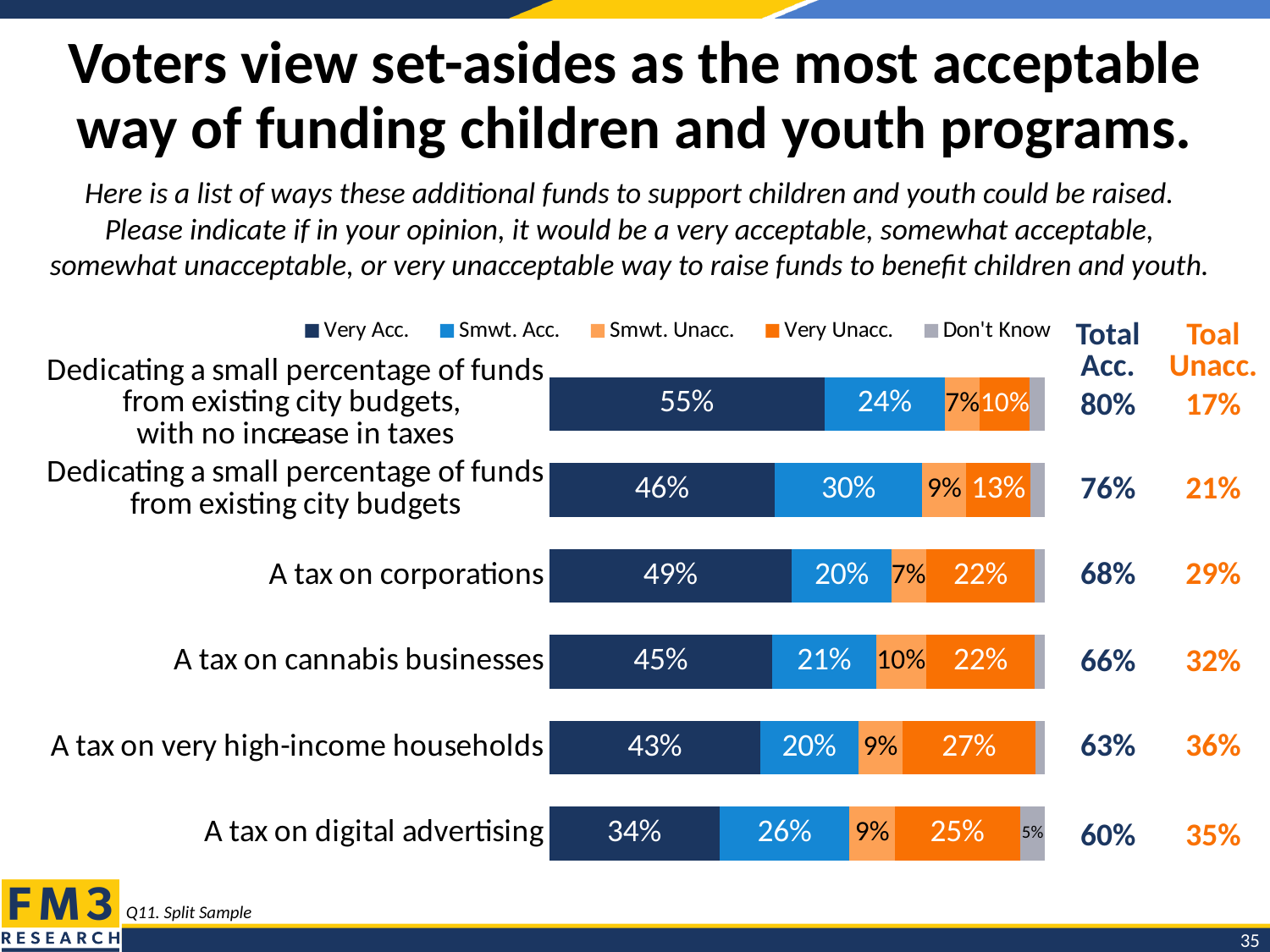
What is the Smwt. Acc. value for 'A tax on digital advertising'? 26% Which has a larger Smwt. Acc. value: 'Dedicating a small percentage of funds from existing city budgets' or 'A tax on corporations'? Dedicating a small percentage of funds from existing city budgets How many funding options are shown in the chart? 6 What is the difference in Very Acc. percentage between 'Dedicating a small percentage of funds from existing city budgets, with no increase in taxes' and 'A tax on digital advertising'? 21 percentage points What is the Very Unacc. value for 'A tax on very high-income households'? 27% What is the Smwt. Unacc. value for 'A tax on cannabis businesses'? 10% How many series does the legend list? 5 Which funding option has the highest Very Acc. percentage? Dedicating a small percentage of funds from existing city budgets, with no increase in taxes What percentage of voters said dedicating a small percentage of funds from existing city budgets, with no increase in taxes, is very acceptable? 55% Which funding option has the highest Very Unacc. percentage? A tax on very high-income households What type of chart is shown on the slide? Stacked bar chart Which funding option has the lowest Very Acc. percentage? A tax on digital advertising